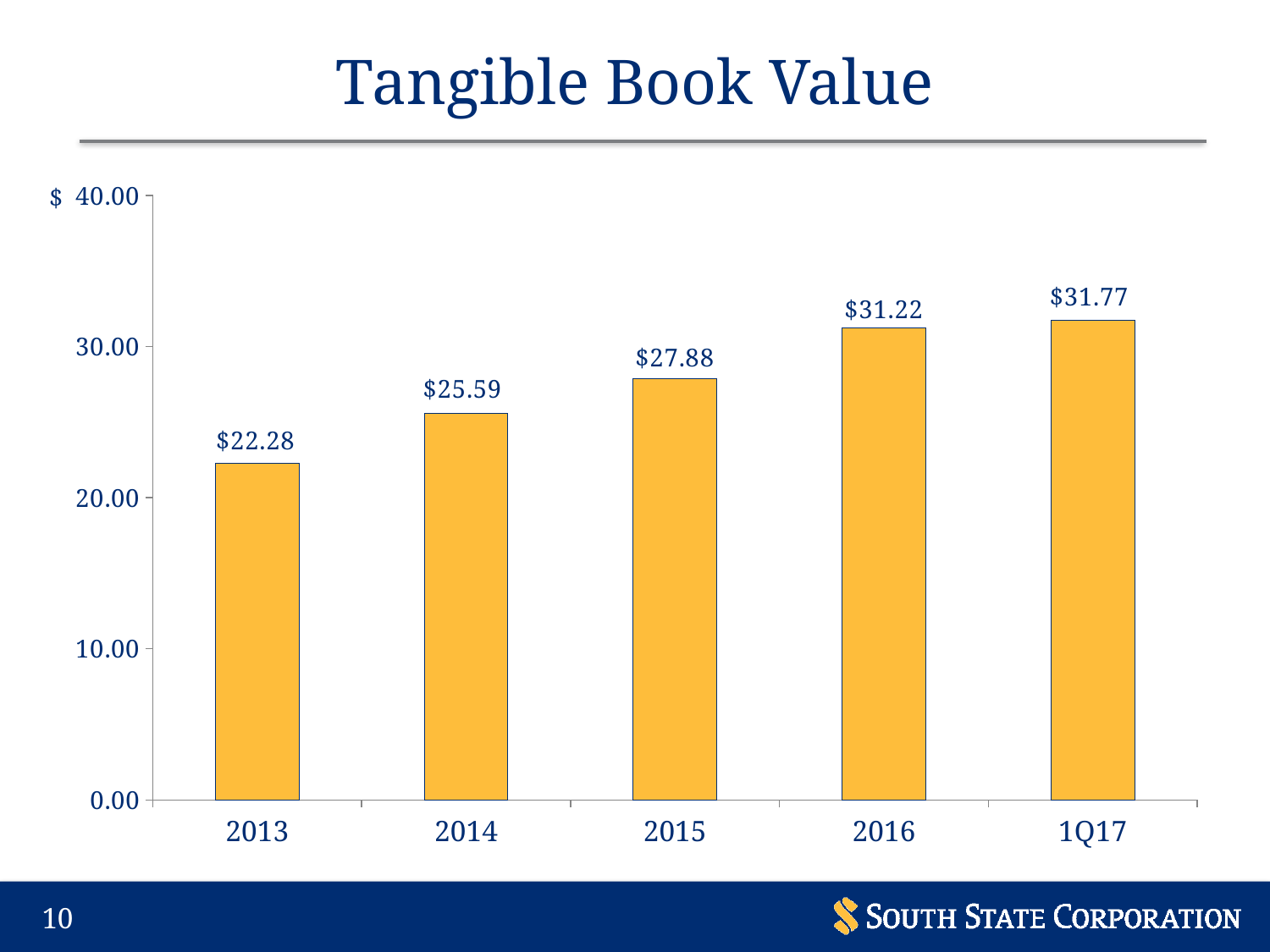
Which is larger, the tangible book value for 2014 or for 2015? 2015 Is the tangible book value for 2016 greater or less than 30.00? greater What is the tangible book value for 2013? $22.28 How many periods are shown on the x axis? 5 What is the difference between the tangible book value in 2016 and in 2013? $8.94 What is the difference between the tangible book value in 1Q17 and in 2016? $0.55 What kind of chart is shown on the slide? Bar chart What is the tangible book value for 2015? $27.88 Which period has the highest tangible book value? 1Q17 Which period has the lowest tangible book value? 2013 Do the tangible book values rise or fall from 2013 to 1Q17? Rise What is the tangible book value for 1Q17? $31.77